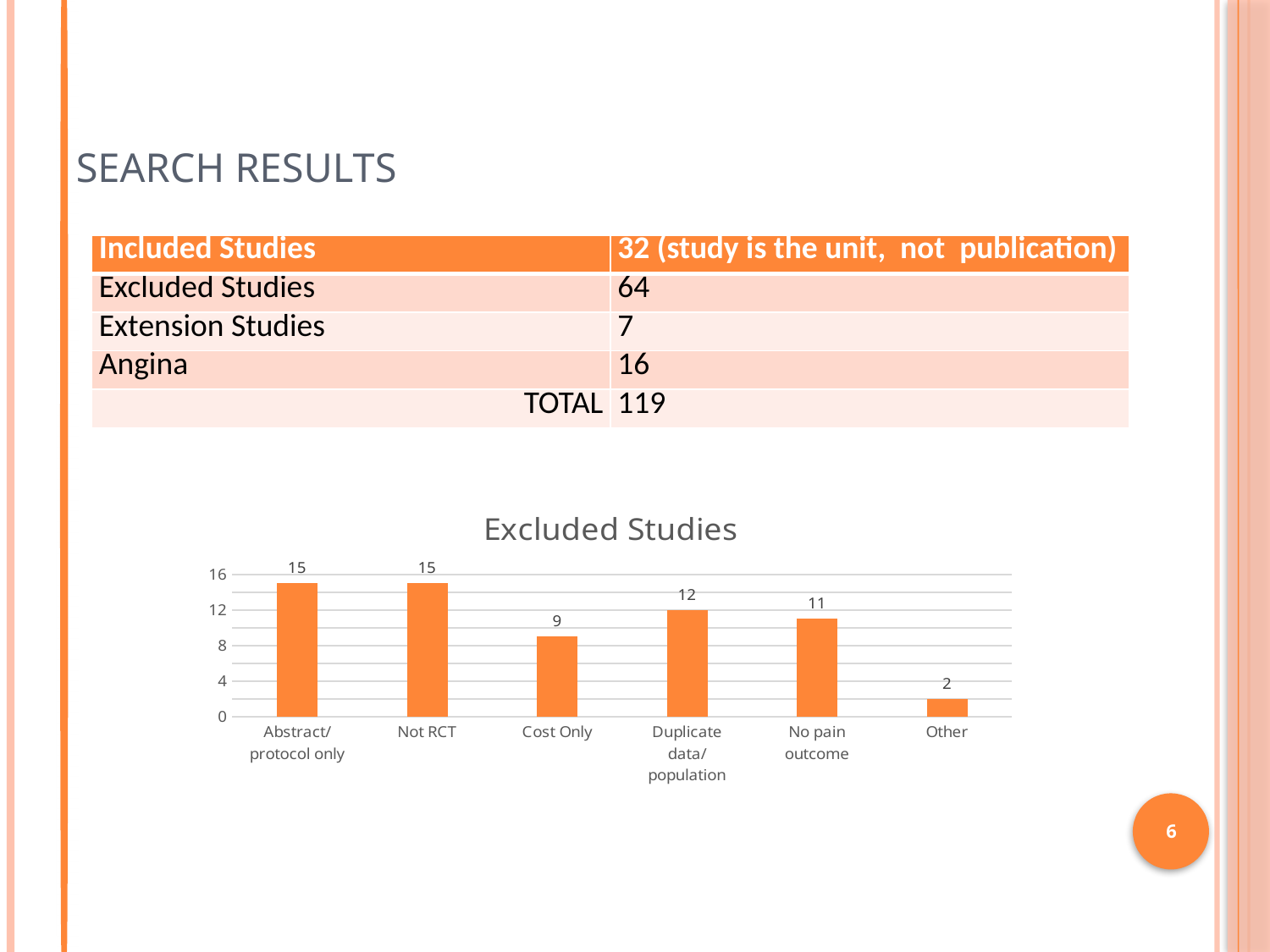
What is the value for Cost Only in the Excluded Studies chart? 9 Is the value for Cost Only in the Excluded Studies chart greater or less than 12? less Which category has the lowest value in the Excluded Studies chart? Other What is the value for Duplicate data/population in the Excluded Studies chart? 12 What is the value for Other in the Excluded Studies chart? 2 What is the difference between the values for Not RCT and Cost Only in the Excluded Studies chart? 6 Which is larger in the Excluded Studies chart, Duplicate data/population or No pain outcome? Duplicate data/population How many categories are shown in the Excluded Studies chart? 6 What is the value for No pain outcome in the Excluded Studies chart? 11 What kind of chart is the Excluded Studies chart? bar chart What is the difference between the values for Duplicate data/population and Other in the Excluded Studies chart? 10 What is the title of the chart on the slide? Excluded Studies